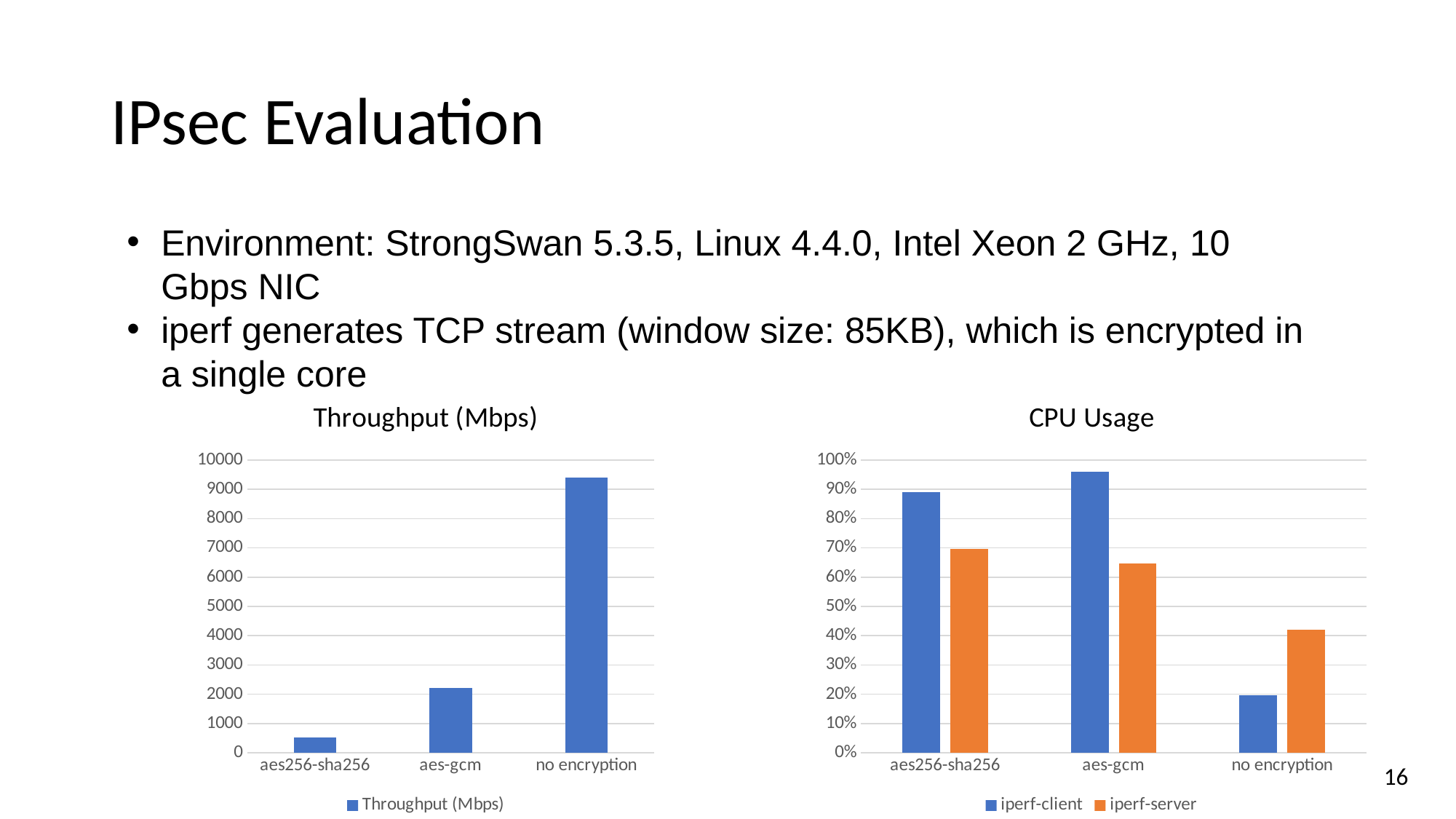
In the CPU Usage chart, for aes256-sha256, which series has the larger value, iperf-client or iperf-server? iperf-client In the CPU Usage chart, which category has the lowest iperf-server CPU usage? no encryption In the Throughput (Mbps) chart, is the value for aes256-sha256 greater or less than 1000? less How many categories are shown on the x axis of the Throughput (Mbps) chart? 3 In the Throughput (Mbps) chart, which category has the lowest throughput? aes256-sha256 In the Throughput (Mbps) chart, which category has the highest throughput? no encryption In the Throughput (Mbps) chart, is the value for no encryption greater or less than 9000? greater How many series does the legend of the CPU Usage chart list? 2 In the CPU Usage chart, is the iperf-client value for no encryption greater or less than 30%? less In the CPU Usage chart, which category has the highest iperf-client CPU usage? aes-gcm In the CPU Usage chart, for no encryption, which series has the larger value, iperf-client or iperf-server? iperf-server What type of chart is the Throughput (Mbps) chart? bar chart